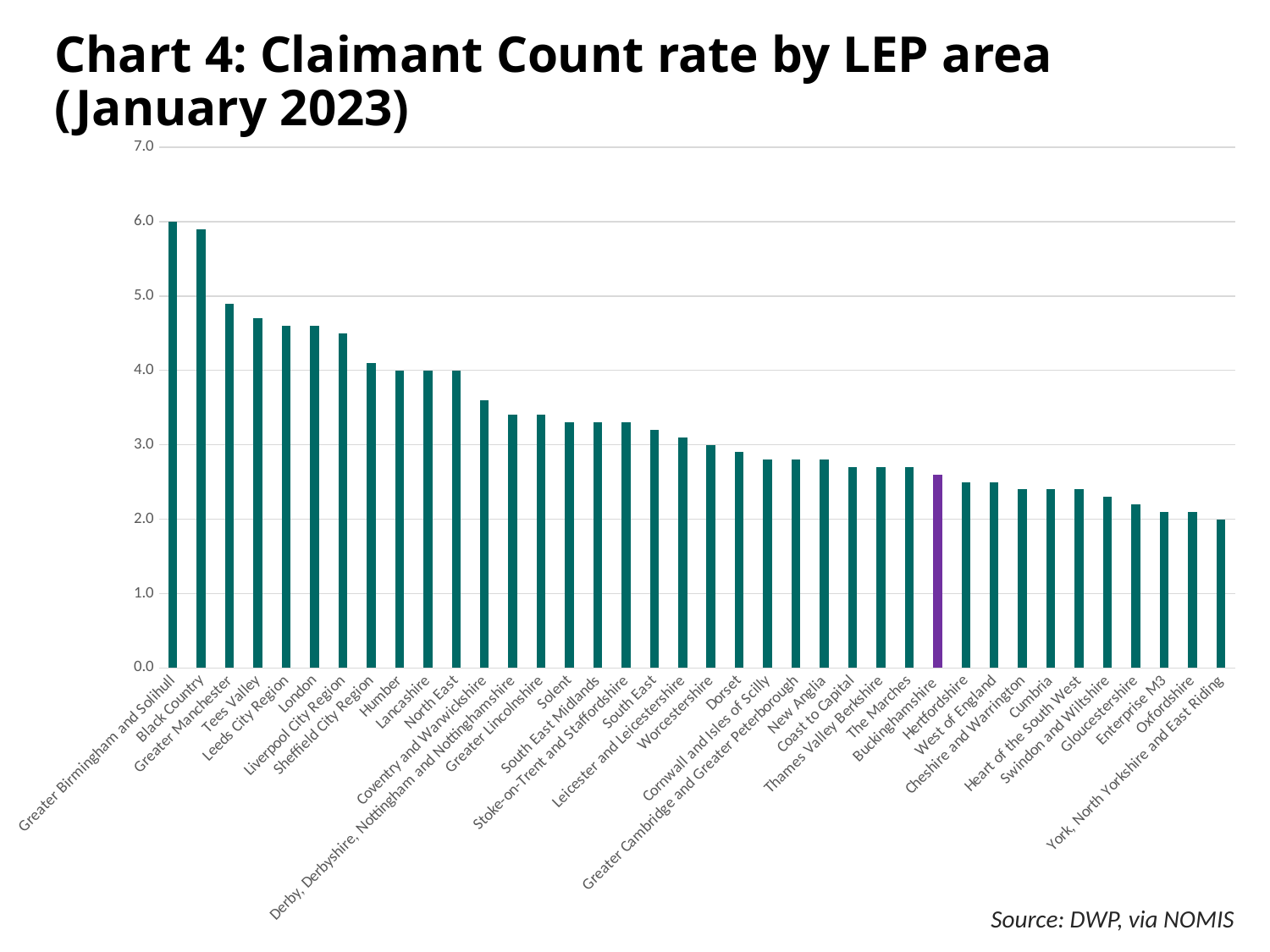
Which LEP area has the highest Claimant Count rate? Greater Birmingham and Solihull Do the Claimant Count rates rise or fall moving from left to right along the x axis? Fall Is the Claimant Count rate for London greater or less than 4.0? greater Is the Claimant Count rate for Oxfordshire greater or less than 3.0? less Which has a higher Claimant Count rate, Greater Manchester or Dorset? Greater Manchester Is the Claimant Count rate for Black Country greater or less than 5.0? greater Which LEP area's bar is highlighted in purple rather than green? Buckinghamshire How many LEP areas are shown on the chart? 38 Which has a higher Claimant Count rate, Cumbria or Tees Valley? Tees Valley Which LEP area has the lowest Claimant Count rate? York, North Yorkshire and East Riding What kind of chart is shown on the slide? Bar chart